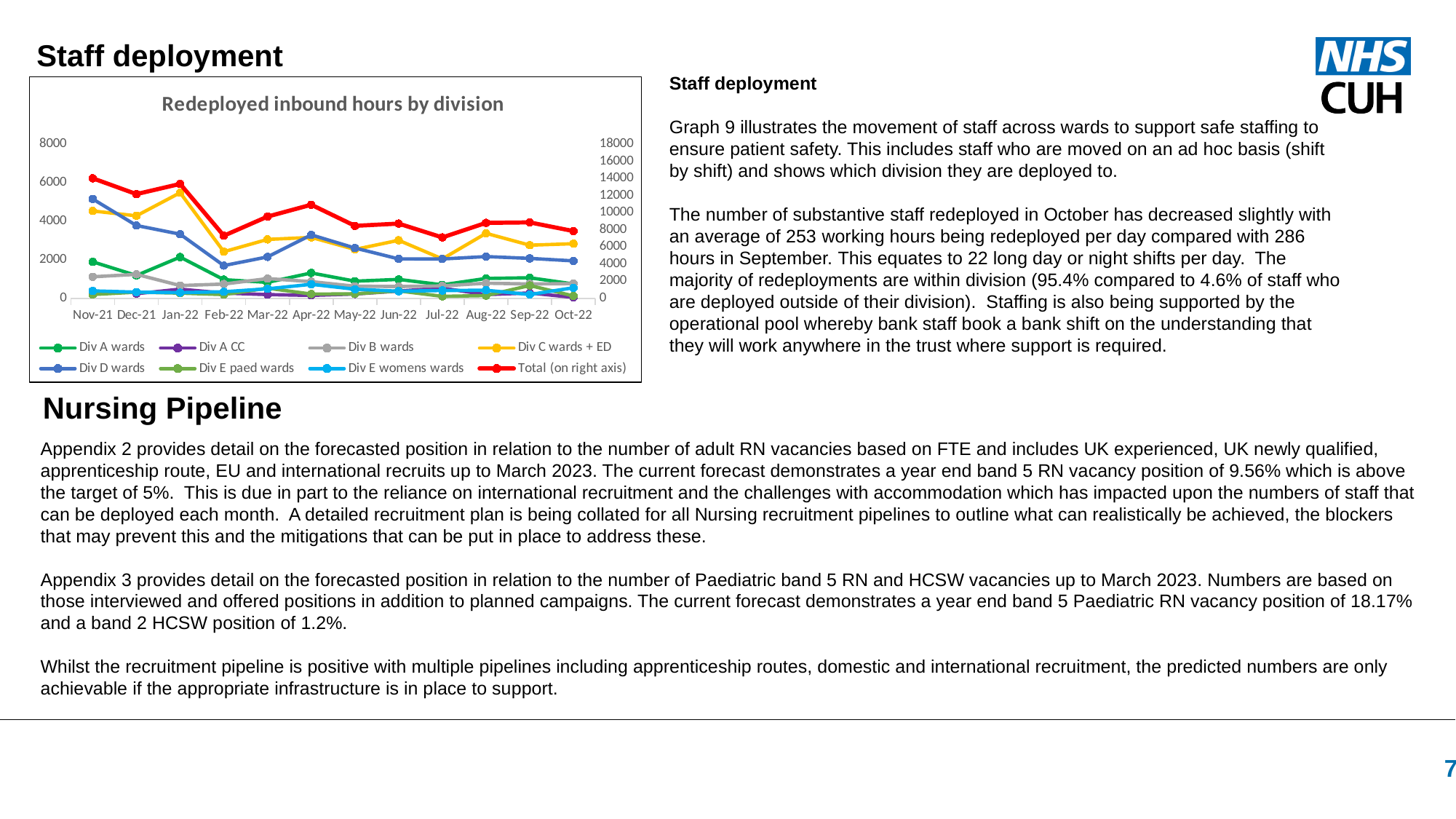
In which month does the Div C wards + ED series reach its highest value? Jan-22 What kind of chart is "Redeployed inbound hours by division"? line chart In which month does the Total (on right axis) series reach its highest value? Nov-21 What is the title of the chart on the slide? Redeployed inbound hours by division Does the Total (on right axis) series overall rise or fall from Nov-21 to Oct-22? fall Which series in the "Redeployed inbound hours by division" chart is plotted on the right axis? Total (on right axis) In Nov-21, which is larger: Div D wards or Div A wards? Div D wards Is the value for Total (on right axis) in Nov-21 greater or less than 12000 on the right axis? greater Is the value for Div D wards in Nov-21 greater or less than 4000? greater Is the value for Div A wards in Nov-21 greater or less than 4000? less How many series does the legend of the "Redeployed inbound hours by division" chart list? 8 How many months are plotted along the x axis of the "Redeployed inbound hours by division" chart? 12